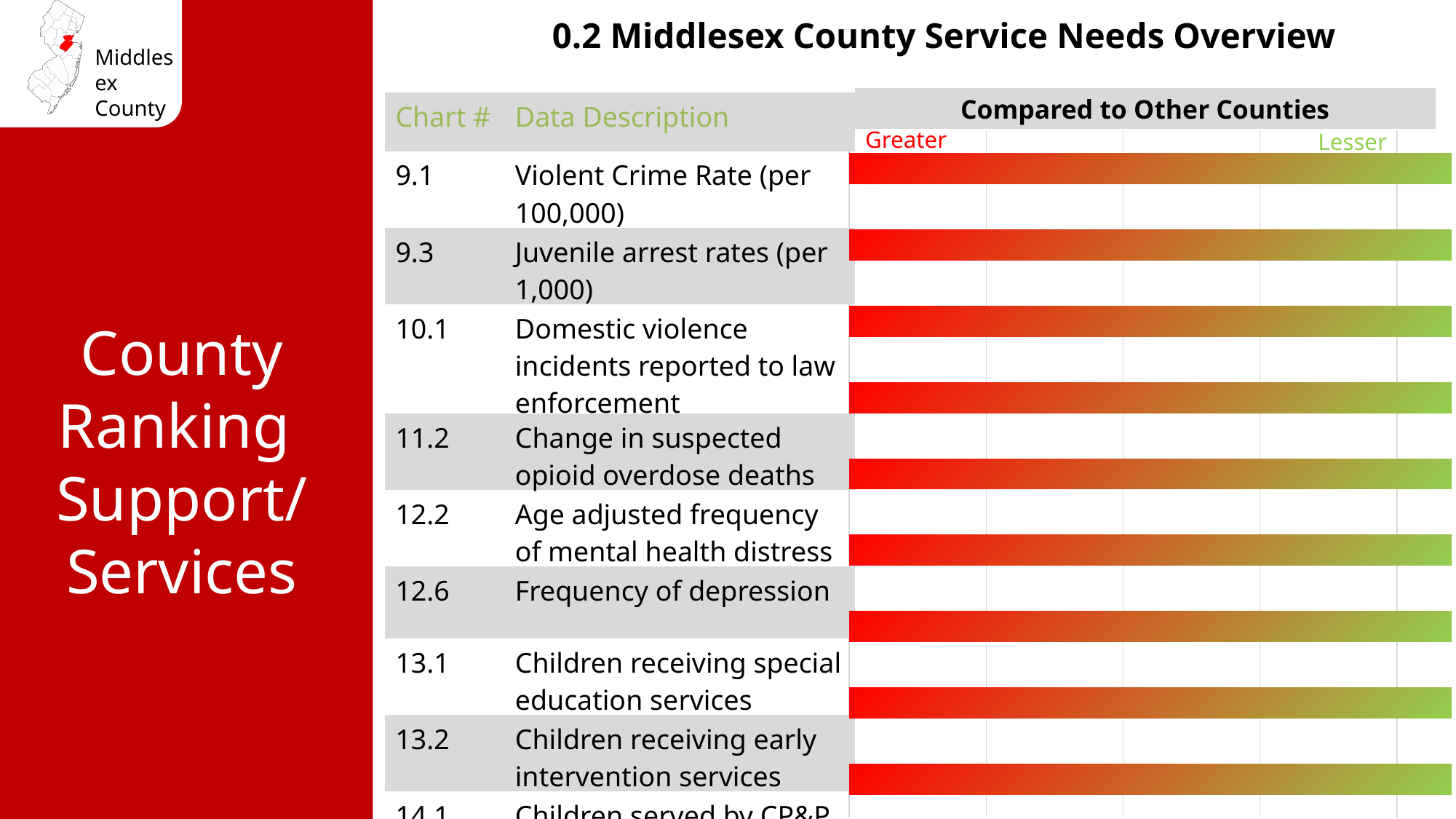
What two labels mark the ends of the 'Compared to Other Counties' scale? Greater and Lesser Which chart number corresponds to 'Violent Crime Rate (per 100,000)'? 9.1 What is the title of the chart on the slide? 0.2 Middlesex County Service Needs Overview Which data description is listed for chart number 12.6? Frequency of depression Which chart number corresponds to 'Change in suspected opioid overdose deaths'? 11.2 What kind of chart is used to show the comparison to other counties? bar chart